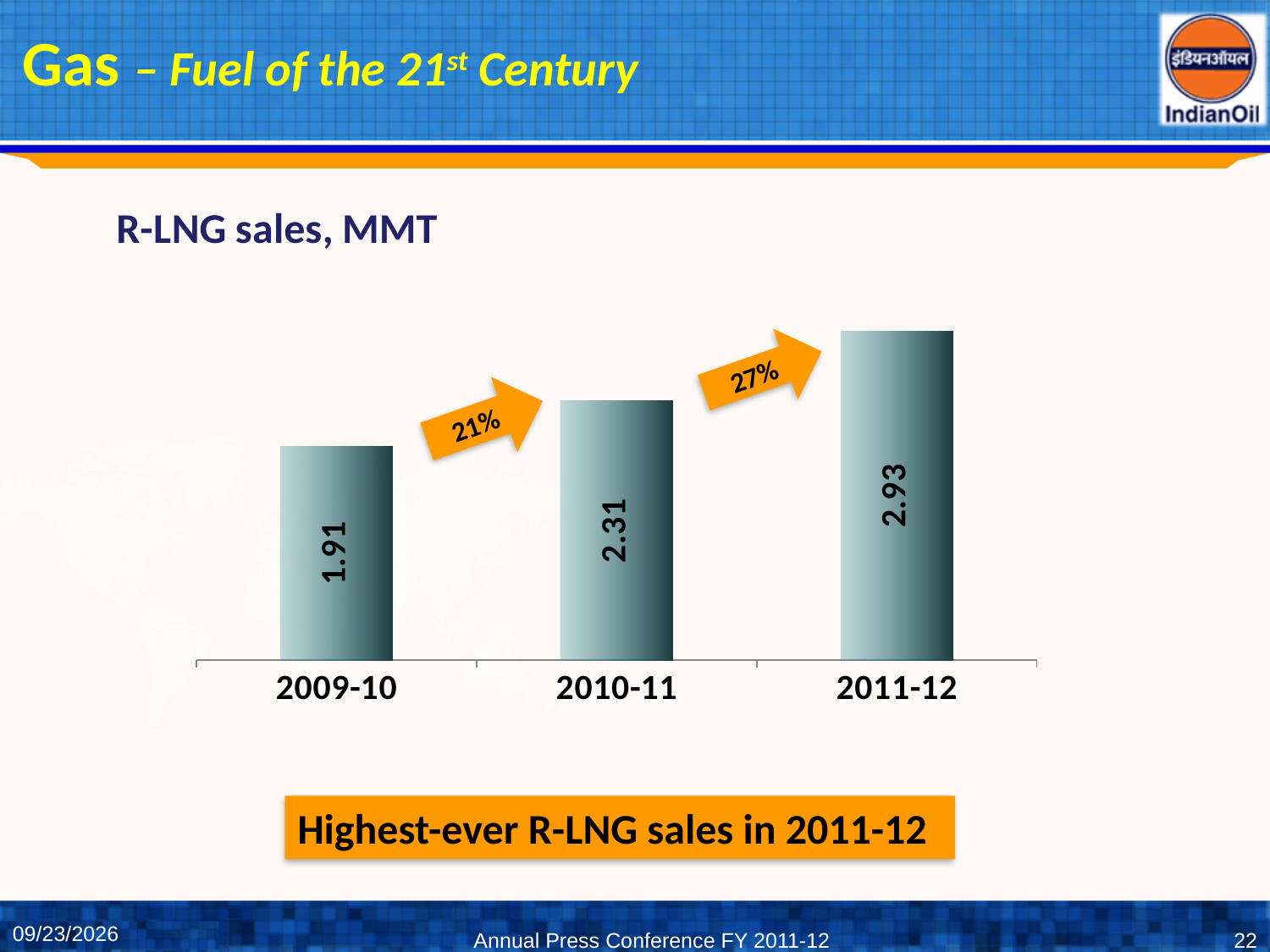
Which year has the lowest R-LNG sales? 2009-10 Which year has higher R-LNG sales, 2009-10 or 2010-11? 2010-11 What kind of chart is shown on the slide? Bar chart How many years are shown on the chart? 3 What is the R-LNG sales value for 2010-11? 2.31 What is the R-LNG sales value for 2009-10? 1.91 What percentage growth is shown by the arrow between 2010-11 and 2011-12? 27% Do R-LNG sales rise or fall from 2009-10 to 2011-12? Rise What is the difference in R-LNG sales between 2011-12 and 2010-11? 0.62 Which year has the highest R-LNG sales? 2011-12 What is the R-LNG sales value for 2011-12? 2.93 What is the difference in R-LNG sales between 2010-11 and 2009-10? 0.40